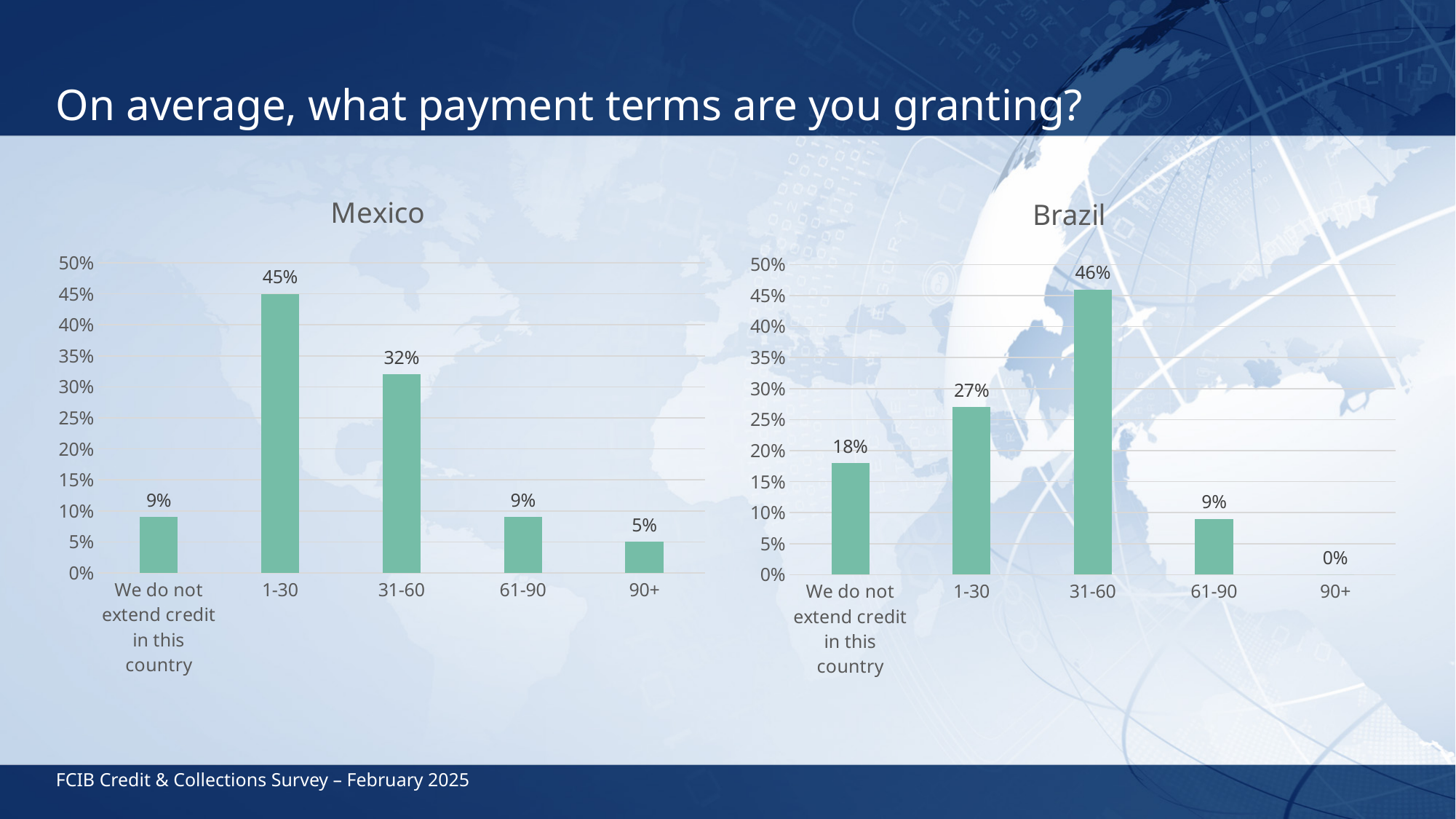
In the Mexico chart, which category has the highest value? 1-30 In the Brazil chart, is the value for 1-30 greater or less than 25%? greater In the Mexico chart, what is the value for 1-30? 45% How many categories are shown in the Mexico chart? 5 In the Brazil chart, what is the difference between the values for 31-60 and 1-30? 19% In the Brazil chart, which category has the lowest value? 90+ In the Mexico chart, which is larger, the value for 31-60 or the value for 61-90? 31-60 What kind of chart is the Brazil chart? bar chart In the Mexico chart, what is the difference between the values for 1-30 and 31-60? 13% In the Brazil chart, what is the value for 31-60? 46% What is the title of the chart on the left side of the slide? Mexico In the Brazil chart, what is the value for 'We do not extend credit in this country'? 18%